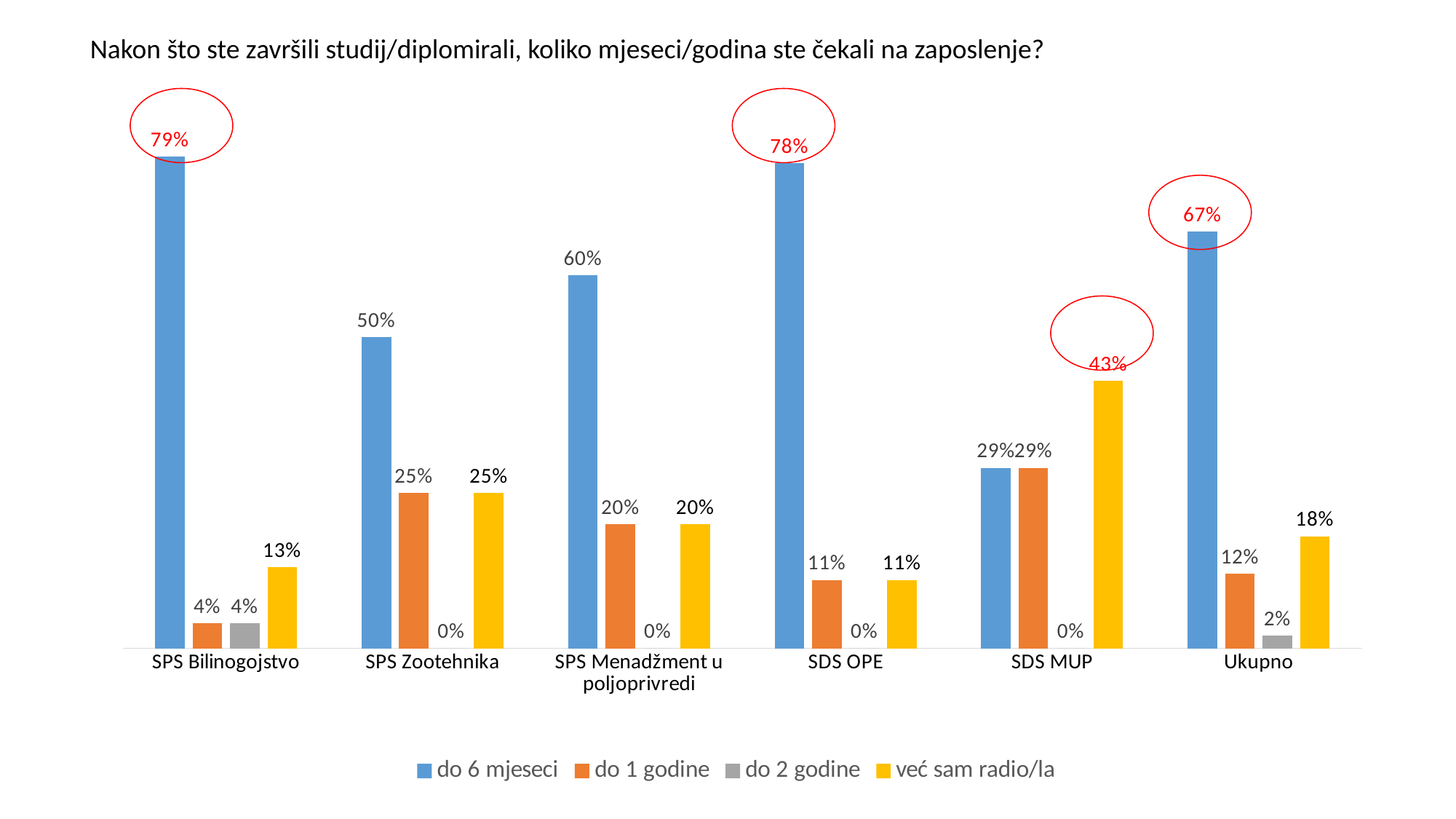
What kind of chart is shown on the slide? bar chart Which series is shown in yellow in the legend? već sam radio/la Which is larger for SDS MUP: 'do 6 mjeseci' or 'već sam radio/la'? već sam radio/la What is the value for 'do 2 godine' for SPS Zootehnika? 0% Which category has the highest value for 'do 6 mjeseci'? SPS Bilinogojstvo What is the value for 'do 6 mjeseci' for SPS Bilinogojstvo? 79% Which category has the lowest value for 'do 6 mjeseci'? SDS MUP How many series does the legend list? 4 What is the value for 'do 1 godine' for Ukupno? 12% What is the value for 'već sam radio/la' for SDS MUP? 43% How many categories are shown on the x axis? 6 What is the difference between the 'do 6 mjeseci' value for SPS Menadžment u poljoprivredi and SPS Zootehnika? 10%